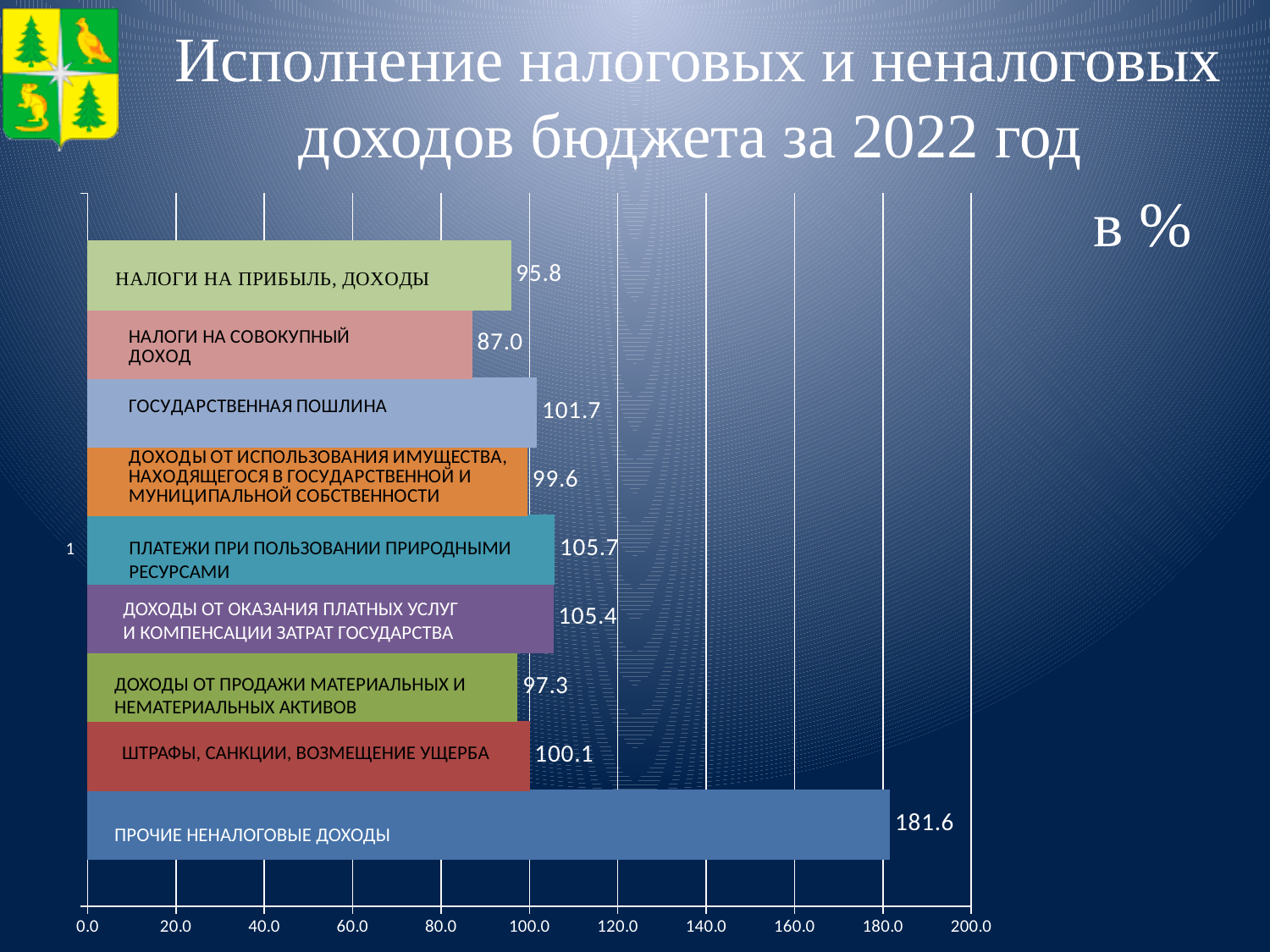
Which category has the lowest value? НАЛОГИ НА СОВОКУПНЫЙ ДОХОД What kind of chart is shown on the slide? bar chart What is the difference between the values for ПРОЧИЕ НЕНАЛОГОВЫЕ ДОХОДЫ and НАЛОГИ НА СОВОКУПНЫЙ ДОХОД? 94.6 What is the value for ШТРАФЫ, САНКЦИИ, ВОЗМЕЩЕНИЕ УЩЕРБА? 100.1 What unit is indicated for the chart values? в % What is the value for НАЛОГИ НА СОВОКУПНЫЙ ДОХОД? 87.0 What is the value for ПРОЧИЕ НЕНАЛОГОВЫЕ ДОХОДЫ? 181.6 Which is larger: the value for НАЛОГИ НА ПРИБЫЛЬ, ДОХОДЫ or the value for ГОСУДАРСТВЕННАЯ ПОШЛИНА? ГОСУДАРСТВЕННАЯ ПОШЛИНА How many categories are shown in the chart? 9 Which category has the highest value? ПРОЧИЕ НЕНАЛОГОВЫЕ ДОХОДЫ What is the value for ГОСУДАРСТВЕННАЯ ПОШЛИНА? 101.7 Is the value for ПРОЧИЕ НЕНАЛОГОВЫЕ ДОХОДЫ greater or less than 160.0? greater